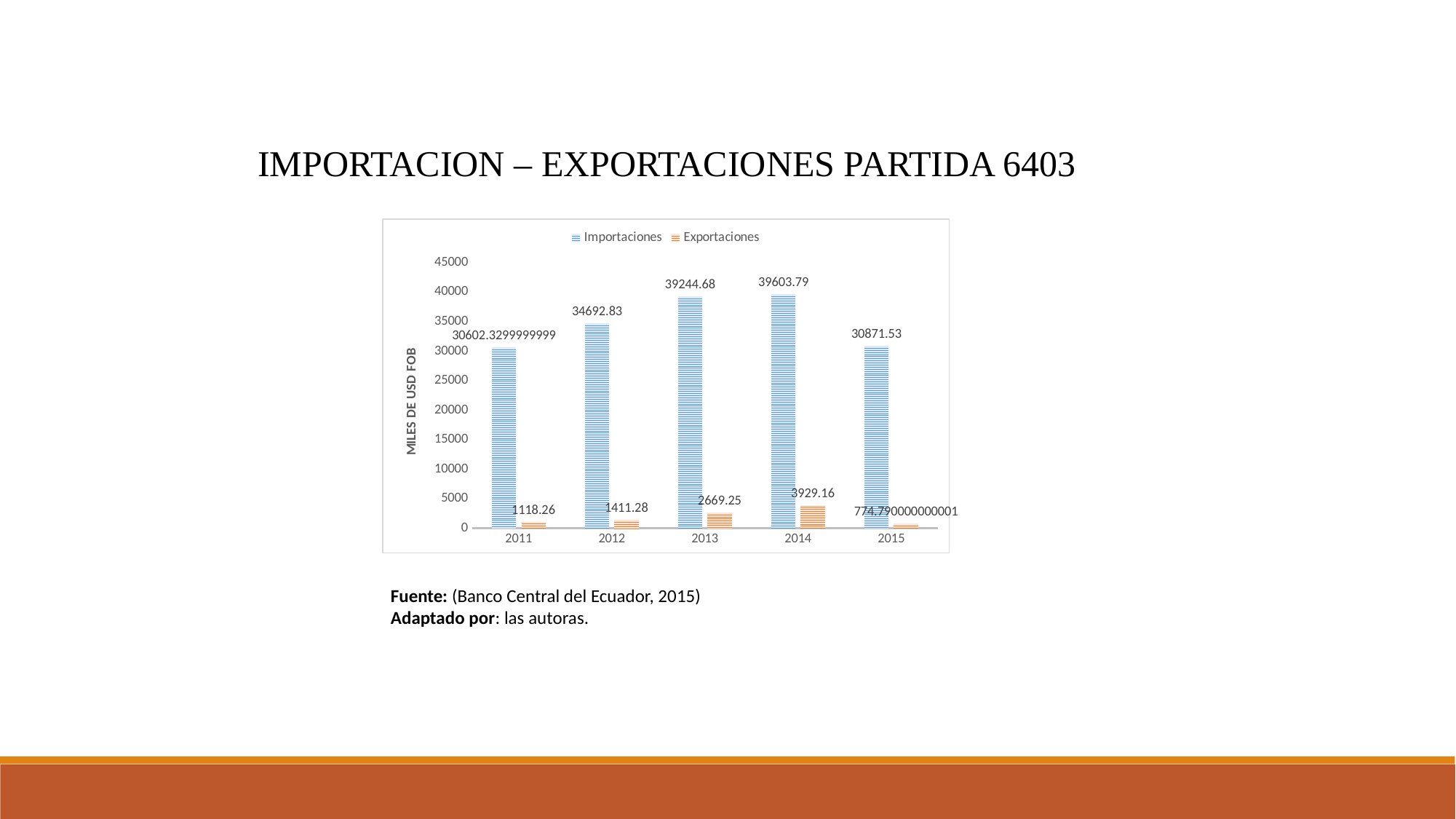
What is the value of Exportaciones in 2014? 3929.16 How many years are shown on the x axis? 5 What is the value of Importaciones in 2013? 39244.68 Which is larger, Exportaciones in 2013 or Exportaciones in 2012? Exportaciones in 2013 By how much did Importaciones increase from 2012 to 2013? 4551.85 What is the difference between Importaciones and Exportaciones in 2014? 35674.63 What is the value of Importaciones in 2015? 30871.53 In which year are Exportaciones lowest? 2015 What is the value of Exportaciones in 2011? 1118.26 In which year are Importaciones highest? 2014 What kind of chart is shown on the slide? Bar chart How many series does the legend list? 2